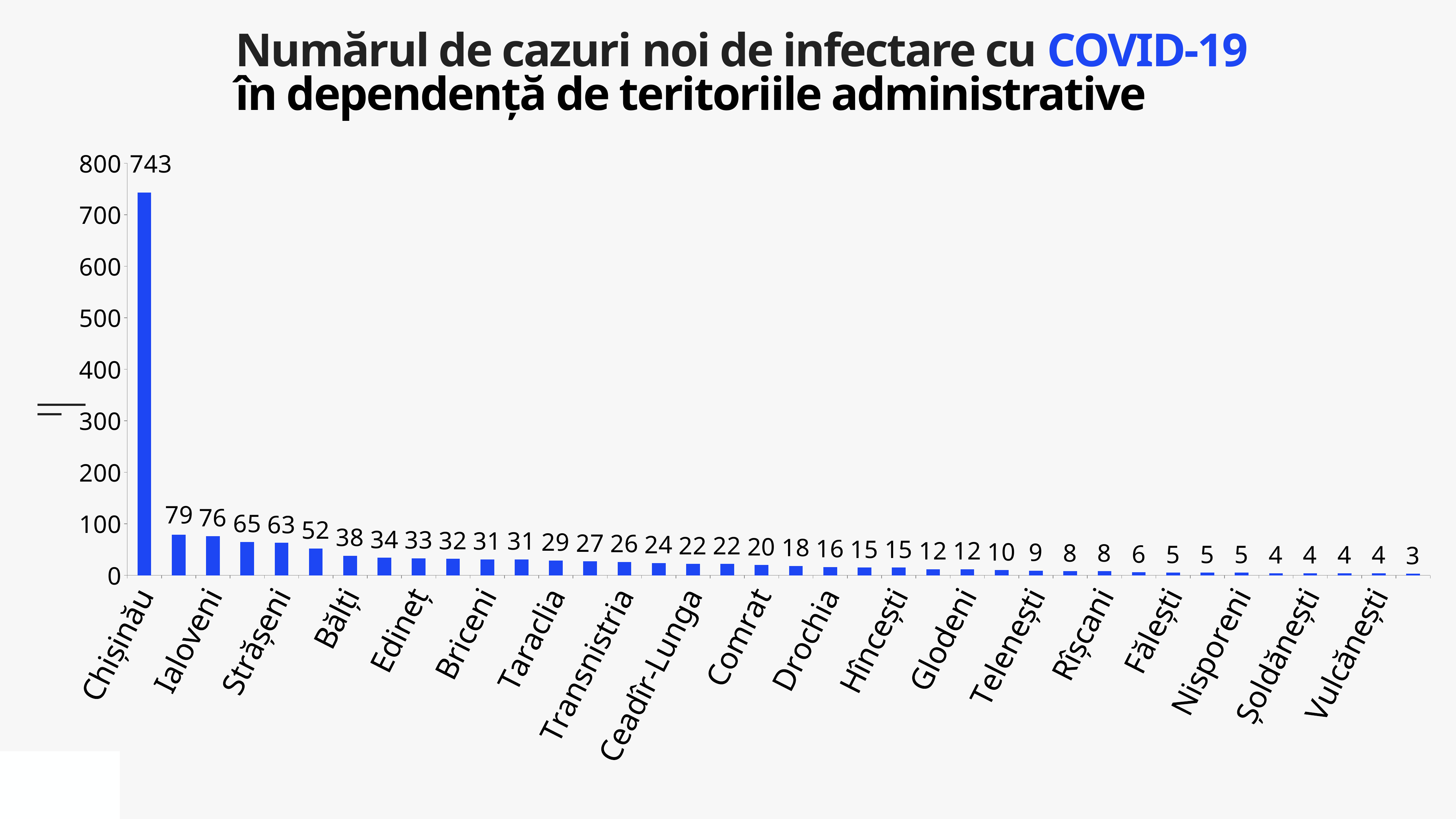
Is the value for Chișinău greater or less than 700? greater What is the smallest data label shown on the chart? 3 Which territory has the highest number of new COVID-19 cases? Chișinău Do the values rise or fall from left to right along the x axis? fall What is the highest value shown on the chart? 743 What colour are the bars in the chart? blue Which has more new cases, Chișinău or Comrat? Chișinău Which has more new cases, Chișinău or Ialoveni? Chișinău Is the value for Bălți greater or less than 100? less What kind of chart is shown on the slide? bar chart Is the value for Ialoveni greater or less than 100? less What is the value for Chișinău? 743